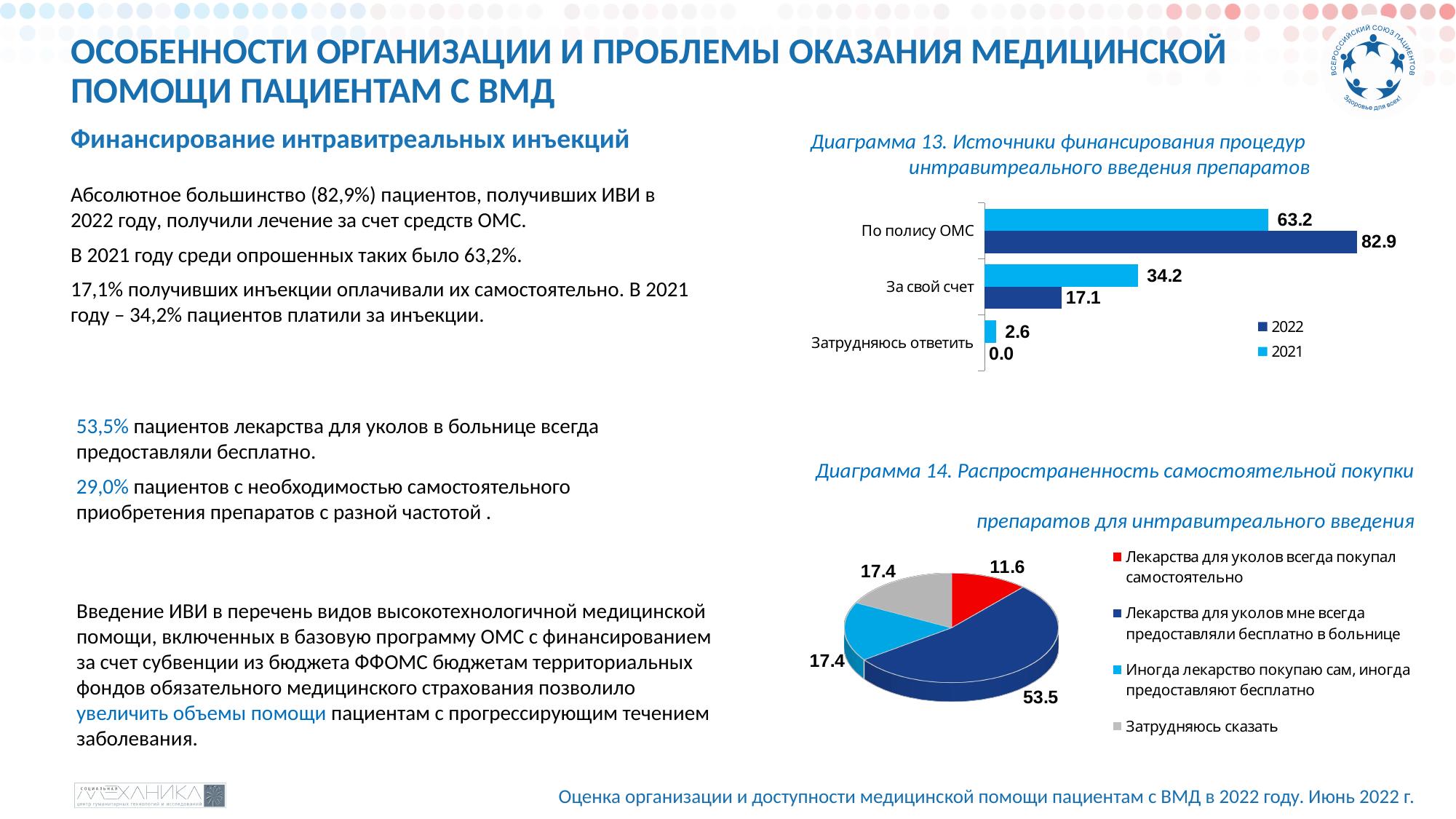
In Диаграмма 13, which category has the highest 2022 value? По полису ОМС In Диаграмма 13, what is the 2021 value for За свой счет? 34.2 How many slices does the pie in Диаграмма 14 have? 4 In Диаграмма 14, which slice is the smallest? Лекарства для уколов всегда покупал самостоятельно In Диаграмма 13, what is the 2022 value for По полису ОМС? 82.9 In Диаграмма 14, what is the value for Лекарства для уколов мне всегда предоставляли бесплатно в больнице? 53.5 In Диаграмма 13, what is the 2022 value for Затрудняюсь ответить? 0.0 In Диаграмма 13, which is larger for За свой счет: the 2021 value or the 2022 value? 2021 In Диаграмма 13, what is the difference between the 2022 and 2021 values for По полису ОМС? 19.7 What type of chart is Диаграмма 13? Bar chart What type of chart is Диаграмма 14? Pie chart How many series does the legend of Диаграмма 13 list? 2